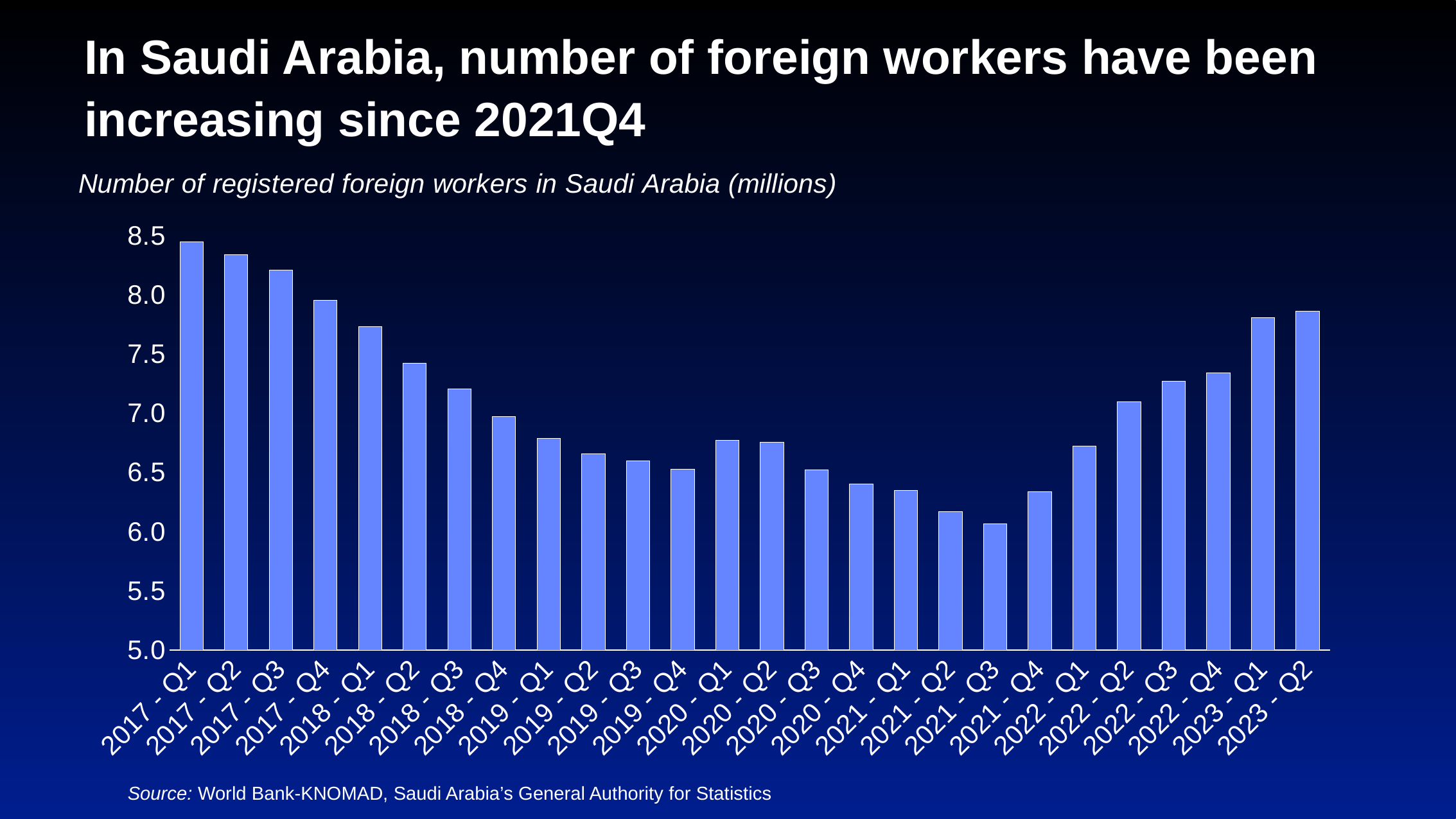
Do the values rise or fall from 2021 - Q4 to 2023 - Q2? rise Is the value for 2019 - Q4 greater or less than 7.0? less How many quarters (bars) are plotted in the chart? 26 What kind of chart is shown on the slide? bar chart Is the value for 2017 - Q4 greater or less than 7.5? greater What unit are the values on the chart expressed in, according to the chart subtitle? millions Which quarter has the lowest number of registered foreign workers? 2021 - Q3 Which quarter has the highest number of registered foreign workers? 2017 - Q1 Which is larger, the value for 2021 - Q2 or the value for 2022 - Q3? 2022 - Q3 Is the value for 2021 - Q3 greater or less than 6.5? less Which is larger, the value for 2018 - Q1 or the value for 2022 - Q1? 2018 - Q1